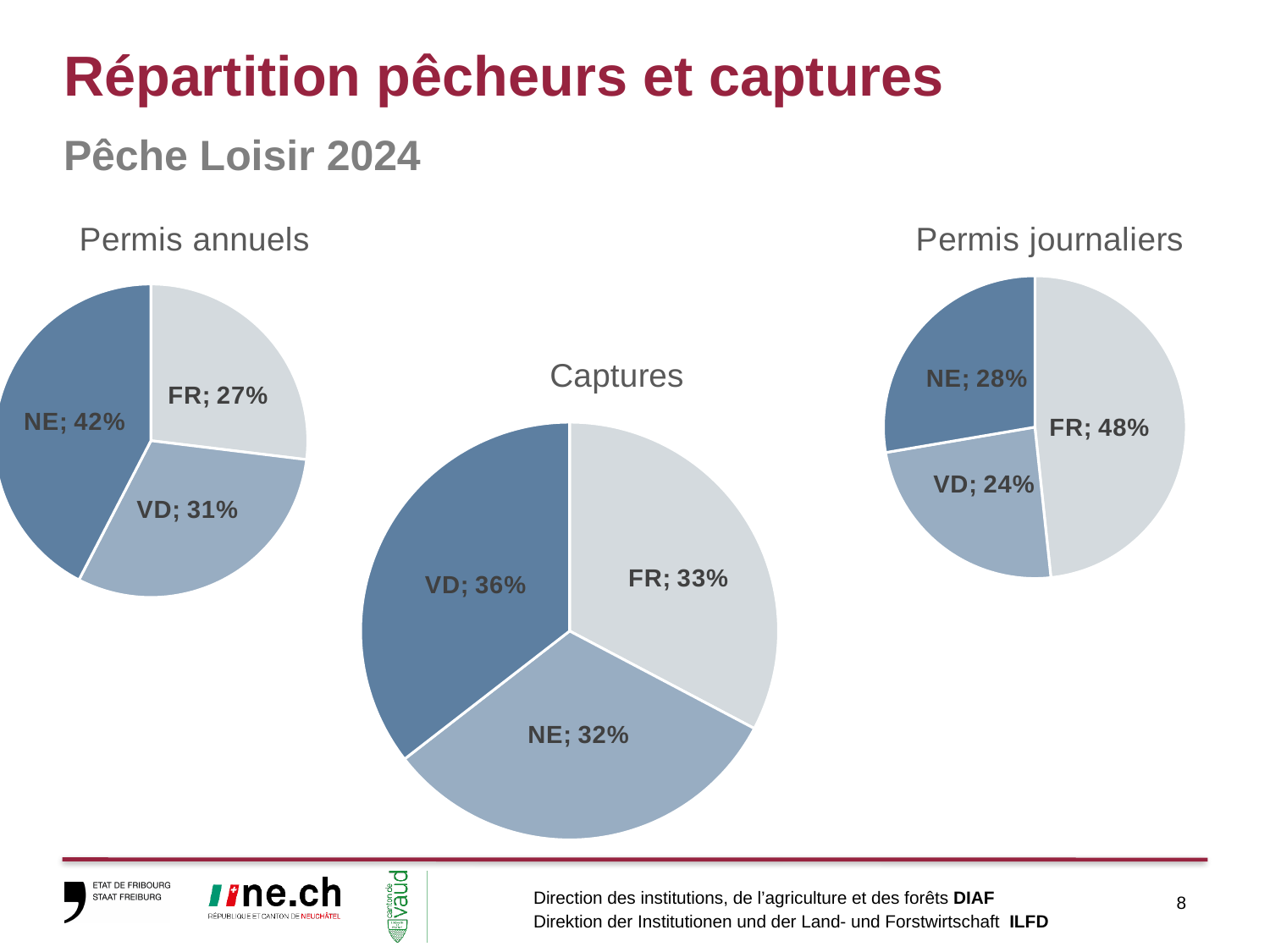
What kind of chart is the 'Captures' chart? Pie chart In the 'Permis journaliers' chart, which canton has the smallest share? VD In the 'Permis annuels' chart, how many slices does the pie have? 3 In the 'Captures' chart, which canton has the largest share? VD In the 'Permis annuels' chart, which canton has the largest share? NE How many pie charts are shown on the slide? 3 In the 'Permis annuels' chart, what share does NE have? 42% In the 'Captures' chart, what share does VD have? 36% In the 'Permis annuels' chart, which canton has the smallest share? FR In the 'Captures' chart, what is the difference between the VD share and the NE share? 4% In the 'Permis journaliers' chart, what share does FR have? 48% In the 'Permis journaliers' chart, what is the difference between the FR share and the NE share? 20%